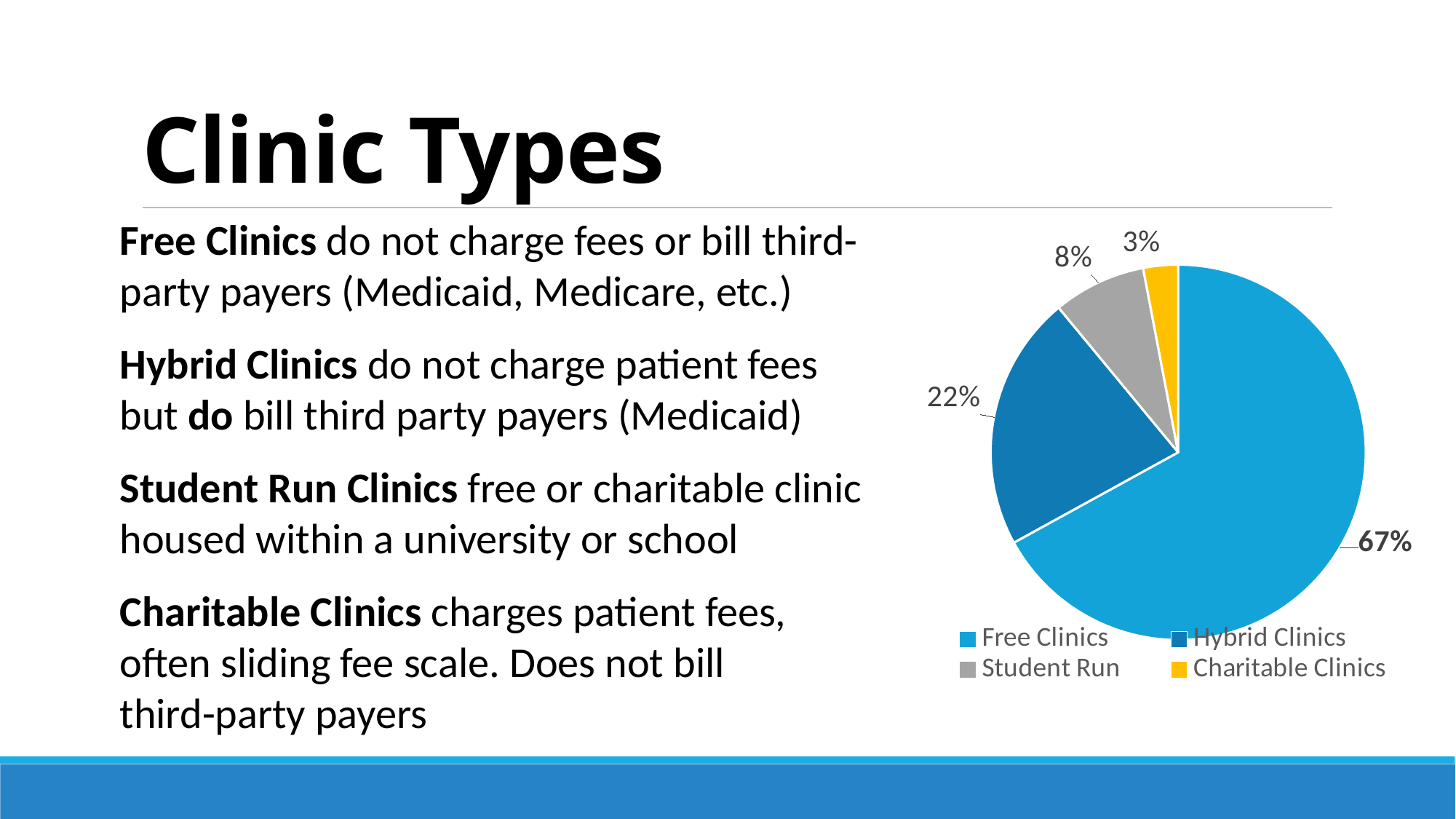
What kind of chart is shown on the slide? pie chart How many percentage points larger is the Free Clinics slice than the Hybrid Clinics slice? 45 What share of the pie is Hybrid Clinics? 22% Which clinic type has the largest slice of the pie? Free Clinics Which clinic type has the smallest slice of the pie? Charitable Clinics What share of the pie is Student Run? 8% What colour is the Charitable Clinics slice? yellow How many entries does the legend list? 4 What share of the pie is Free Clinics? 67% How many slices does the pie chart have? 4 Which is larger, the Student Run slice or the Charitable Clinics slice? Student Run What share of the pie is Charitable Clinics? 3%